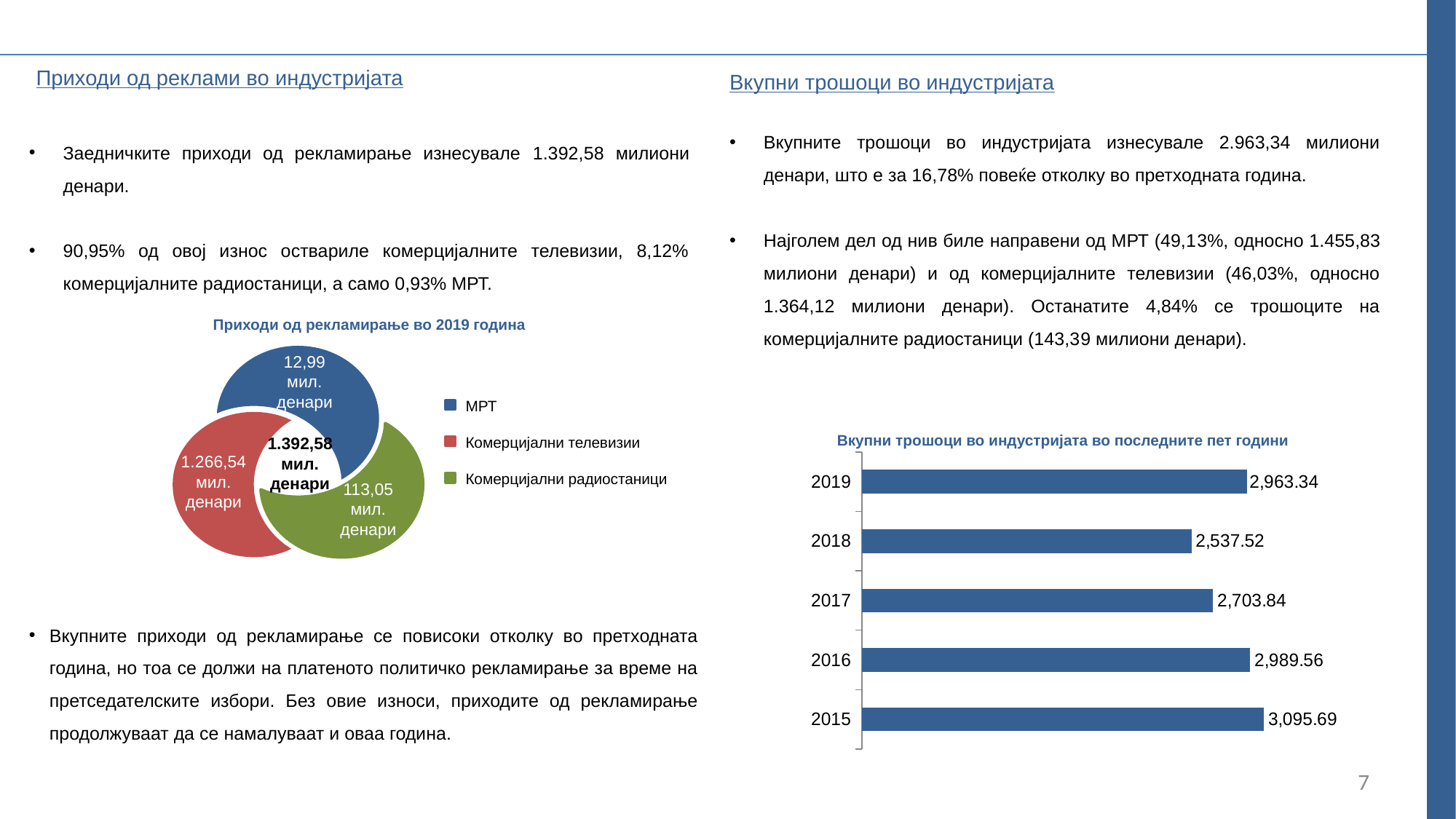
How many years are shown in the chart 'Вкупни трошоци во индустријата во последните пет години'? 5 How many entries does the legend of the diagram 'Приходи од рекламирање во 2019 година' list? 3 In the chart 'Вкупни трошоци во индустријата во последните пет години', which year has the highest value? 2015 What kind of chart is 'Вкупни трошоци во индустријата во последните пет години'? bar chart In the diagram 'Приходи од рекламирање во 2019 година', which category has the largest value? Комерцијални телевизии In the chart 'Вкупни трошоци во индустријата во последните пет години', what is the value for 2017? 2,703.84 In the diagram 'Приходи од рекламирање во 2019 година', what is the value for МРТ? 12,99 мил. денари In the chart 'Вкупни трошоци во индустријата во последните пет години', what is the value for 2019? 2,963.34 In the chart 'Вкупни трошоци во индустријата во последните пет години', which is larger, the value for 2016 or the value for 2019? 2016 In the chart 'Вкупни трошоци во индустријата во последните пет години', did the value rise or fall from 2018 to 2019? rise In the chart 'Вкупни трошоци во индустријата во последните пет години', which year has the lowest value? 2018 In the chart 'Вкупни трошоци во индустријата во последните пет години', what is the difference between the values for 2019 and 2018? 425.82